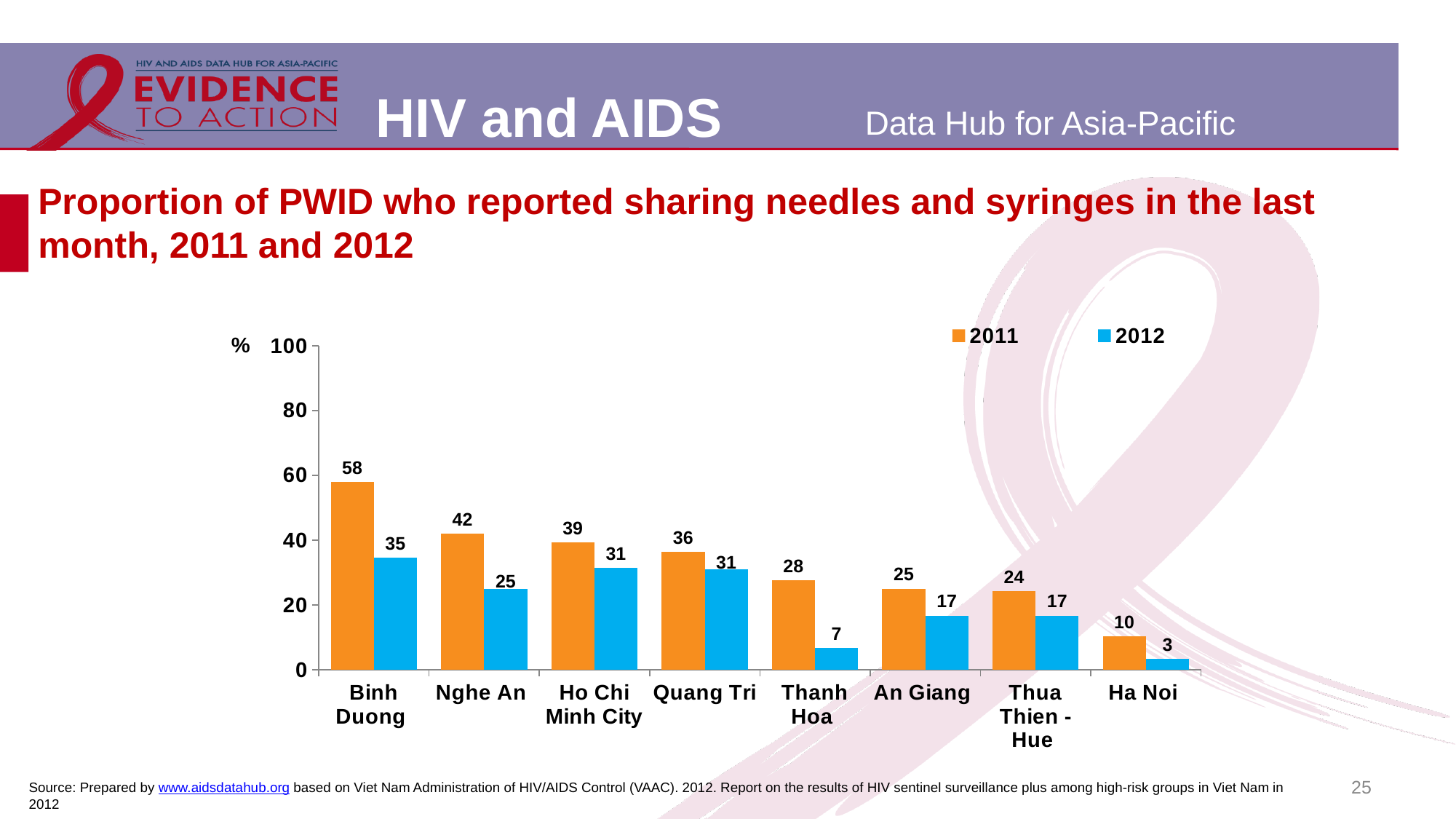
What kind of chart is shown on the slide? Bar chart What was the 2012 value for Thanh Hoa? 7 Which colour represents the 2012 series in the chart? Blue What is the difference between the 2011 values for Nghe An and Ho Chi Minh City? 3 Which is larger: the 2012 value for Nghe An or the 2012 value for Ho Chi Minh City? Ho Chi Minh City How many series does the legend list? 2 How many provinces are shown on the x axis? 8 What was the 2012 value for Ha Noi? 3 What is the difference between the 2011 and 2012 values for Binh Duong? 23 What was the proportion of PWID who reported sharing needles and syringes in Binh Duong in 2011? 58 Which province had the highest proportion in 2011? Binh Duong Which province had the lowest proportion in 2012? Ha Noi